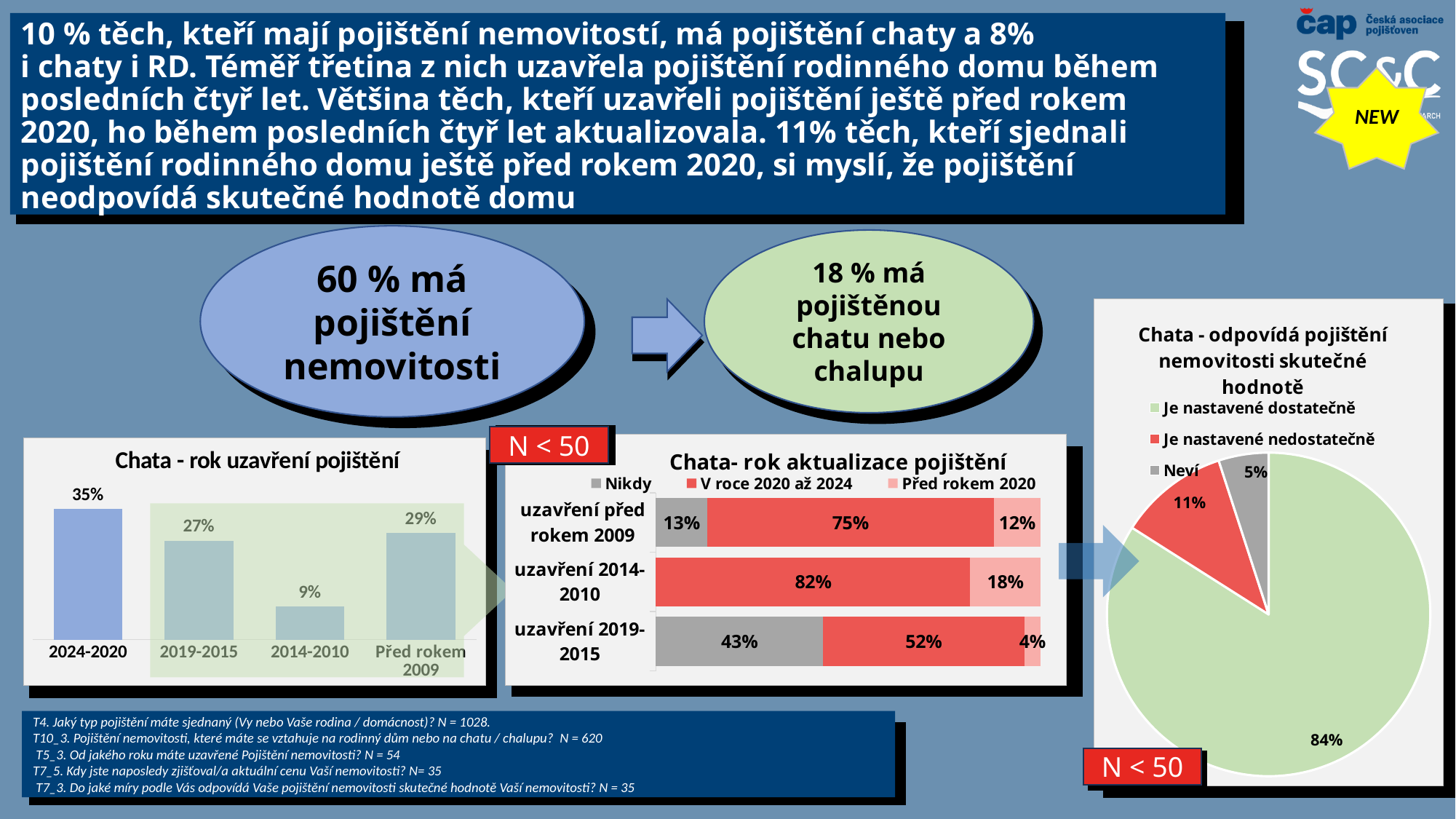
In the chart 'Chata- rok aktualizace pojištění', how many series does the legend list? 3 In the pie chart 'Chata - odpovídá pojištění nemovitosti skutečné hodnotě', what share is 'Je nastavené dostatečně'? 84% In the chart 'Chata - rok uzavření pojištění', what is the value for 2024-2020? 35% In the chart 'Chata - rok uzavření pojištění', which category has the lowest value? 2014-2010 In the chart 'Chata- rok aktualizace pojištění', what is the 'V roce 2020 až 2024' value for 'uzavření 2014-2010'? 82% In the pie chart 'Chata - odpovídá pojištění nemovitosti skutečné hodnotě', what is the value for 'Neví'? 5% In the chart 'Chata- rok aktualizace pojištění', which is larger for 'uzavření před rokem 2009': the 'Nikdy' value or the 'Před rokem 2020' value? Nikdy What kind of chart is 'Chata - odpovídá pojištění nemovitosti skutečné hodnotě'? Pie chart In the chart 'Chata- rok aktualizace pojištění', what is the 'Nikdy' value for 'uzavření 2019-2015'? 43% In the chart 'Chata - rok uzavření pojištění', how many categories are shown? 4 In the chart 'Chata - rok uzavření pojištění', what is the difference between the values for 2024-2020 and 2019-2015? 8% What kind of chart is 'Chata - rok uzavření pojištění'? Bar chart